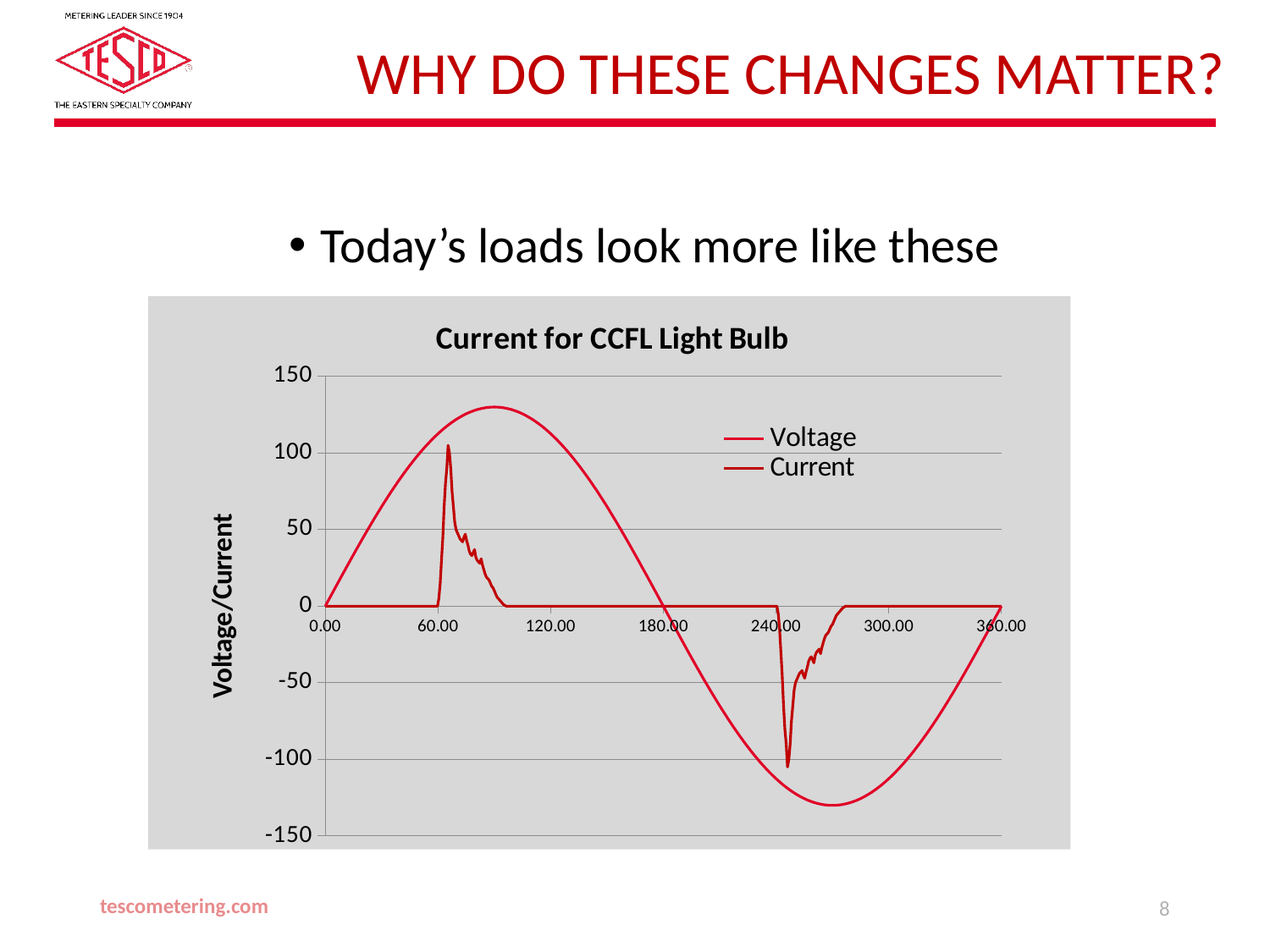
Is the lowest Voltage value greater or less than -100? less Does the Voltage series rise or fall between 120.00 and 240.00 on the x axis? fall Does the Voltage series rise or fall between 0.00 and 60.00 on the x axis? rise Is the peak Current value greater or less than 50? greater What is the Voltage value at 180.00 on the x axis? 0 What is the title of the chart? Current for CCFL Light Bulb How many series does the legend of the chart list? 2 What kind of chart is shown on the slide? line chart What is the Current value at 120.00 on the x axis? 0 Is the peak Voltage value greater or less than 100? greater How many tick labels are shown on the x axis of the chart? 7 What is the label on the vertical axis of the chart? Voltage/Current